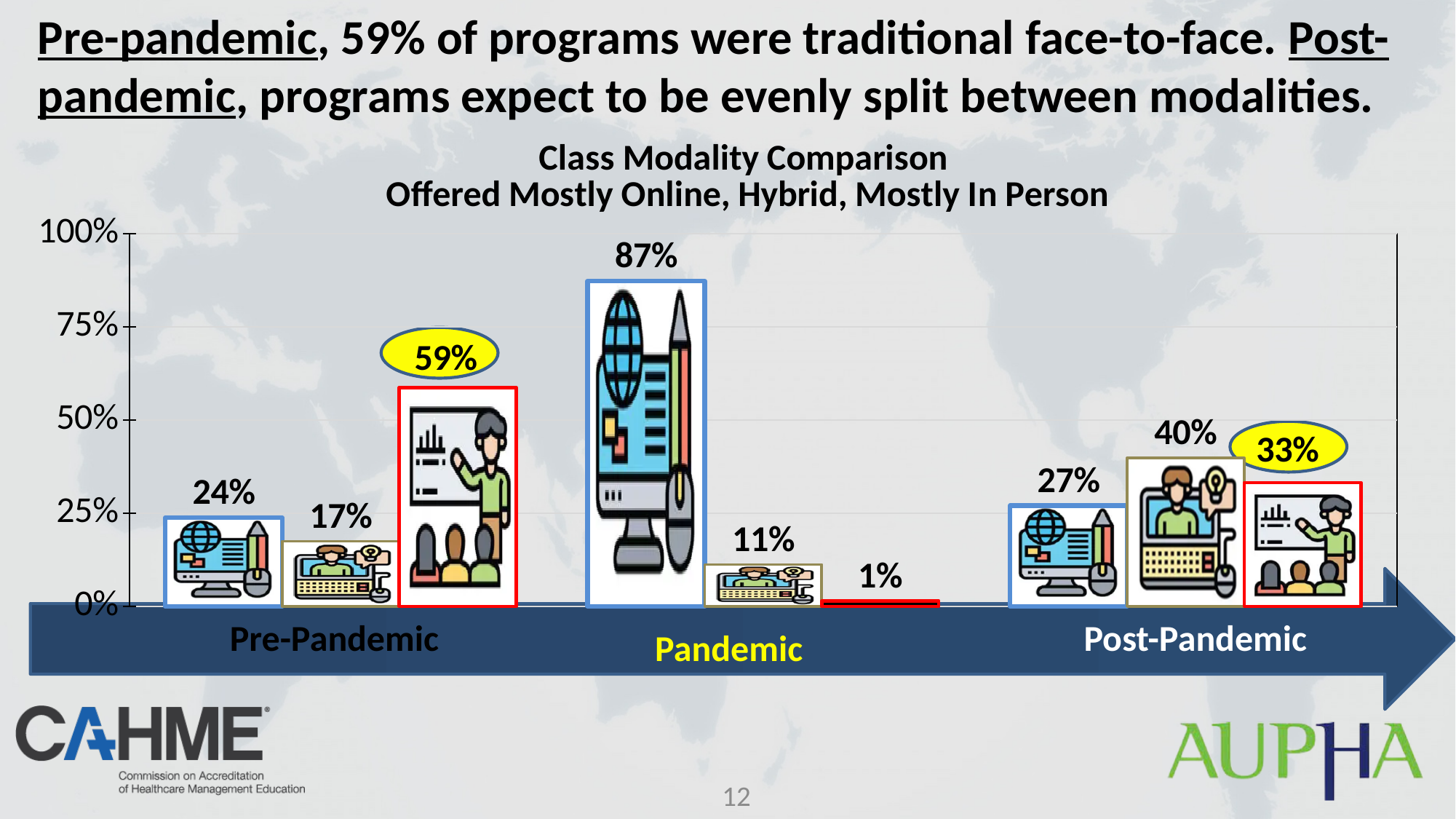
What is the difference between the mostly online value during the pandemic (87%) and the mostly online value pre-pandemic (24%)? 63% What kind of chart is shown on the slide? bar chart How do the mostly in person values change from Pre-Pandemic to Pandemic to Post-Pandemic? fall from 59% to 1%, then rise to 33% What percentage of programs were mostly online during the pandemic? 87% Is the pre-pandemic mostly in person value greater or less than 50%? greater What is the title of the chart? Class Modality Comparison Offered Mostly Online, Hybrid, Mostly In Person What is the value for hybrid programs post-pandemic? 40% What percentage of programs were mostly in person pre-pandemic? 59% How many time-period categories are shown along the x axis? 3 Which time period has the highest single bar value? Pandemic What is the value for mostly in person programs during the pandemic? 1% Which is larger post-pandemic: the hybrid value or the mostly in person value? hybrid (40%)